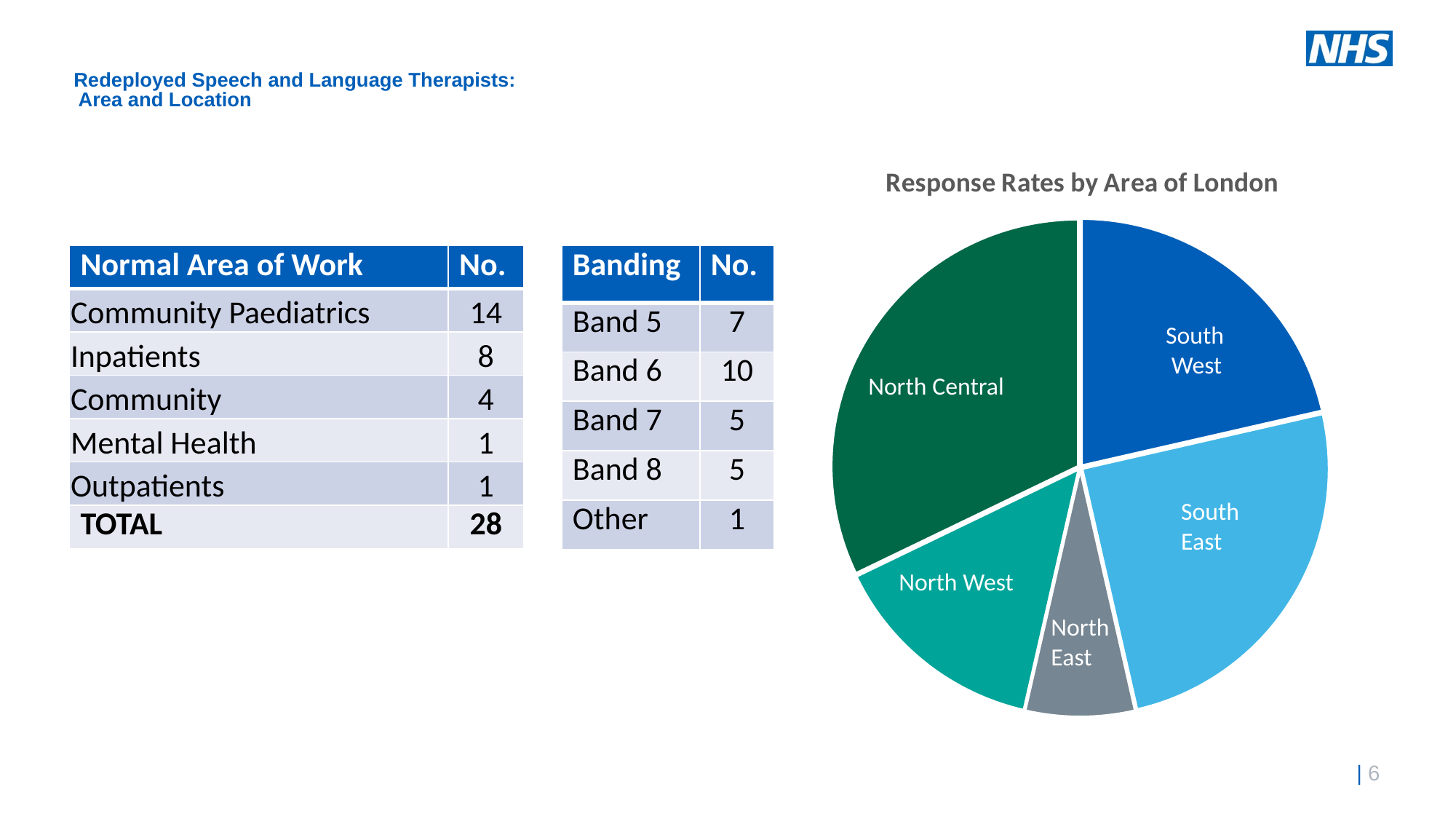
Which area has the largest slice in the pie chart? North Central Which slice of the pie chart is coloured grey? North East How many slices does the pie chart have? 5 Which area has the smallest slice in the pie chart? North East In the pie chart, which slice is larger: North East or South West? South West In the pie chart, which slice is larger: South East or North West? South East In the pie chart, which slice is larger: North West or North East? North West What kind of chart is shown on the slide? pie chart What is the title of the chart on the slide? Response Rates by Area of London